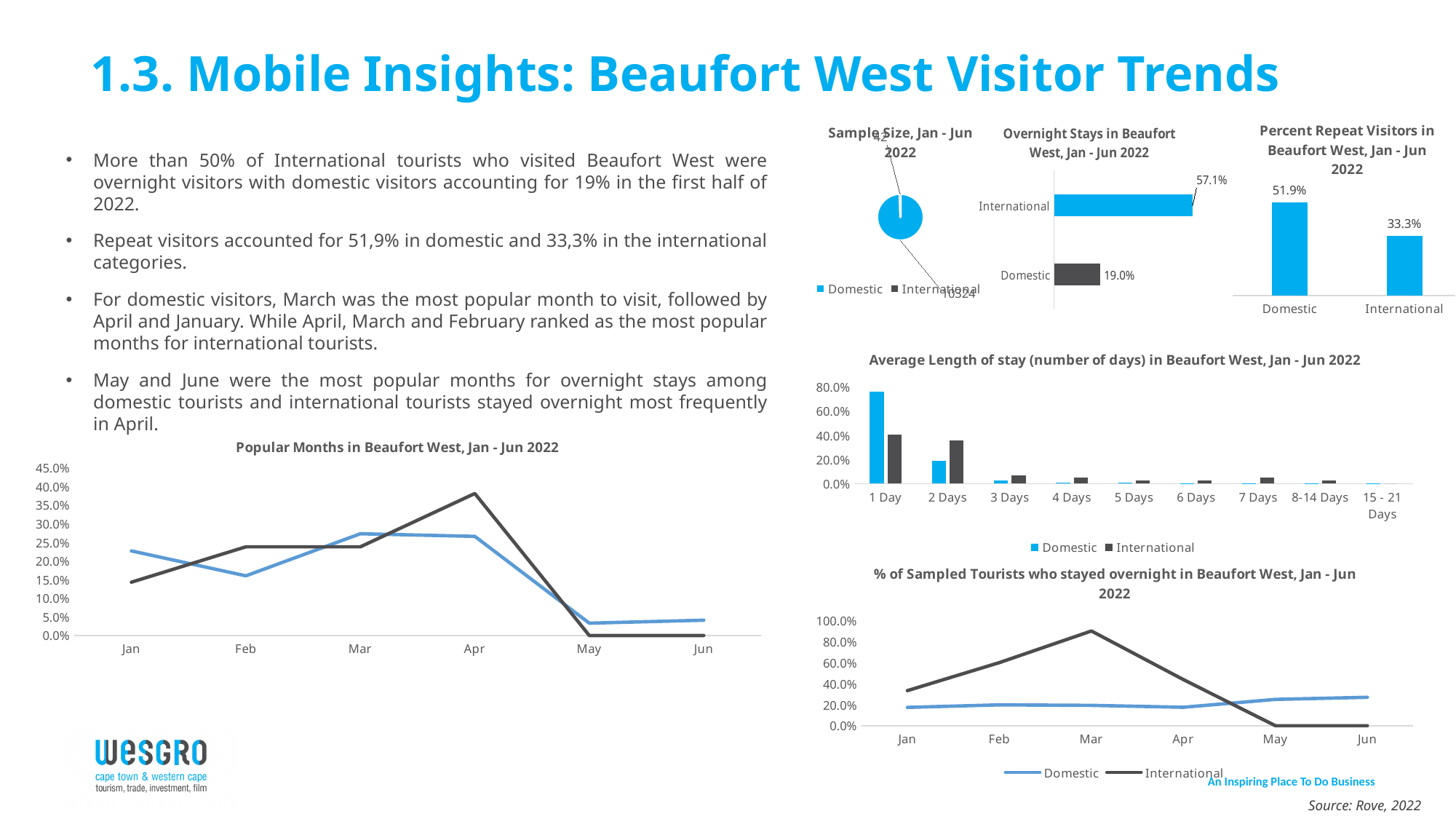
In the 'Average Length of stay (number of days) in Beaufort West, Jan - Jun 2022' chart, is the Domestic value for 1 Day greater or less than 60.0%? greater In the 'Percent Repeat Visitors in Beaufort West, Jan - Jun 2022' chart, what is the difference between the Domestic and International values? 18.6% In the '% of Sampled Tourists who stayed overnight in Beaufort West, Jan - Jun 2022' chart, how many series does the legend list? 2 What kind of chart is 'Average Length of stay (number of days) in Beaufort West, Jan - Jun 2022'? bar chart In the 'Percent Repeat Visitors in Beaufort West, Jan - Jun 2022' chart, which category has the higher value? Domestic In the 'Percent Repeat Visitors in Beaufort West, Jan - Jun 2022' chart, what is the value for Domestic? 51.9% In the 'Sample Size, Jan - Jun 2022' pie chart, which category has the larger share, Domestic or International? Domestic In the 'Overnight Stays in Beaufort West, Jan - Jun 2022' chart, what is the difference between the International and Domestic values? 38.1% In the 'Average Length of stay (number of days) in Beaufort West, Jan - Jun 2022' chart, how many length-of-stay categories are shown on the x axis? 9 In the '% of Sampled Tourists who stayed overnight in Beaufort West, Jan - Jun 2022' chart, in which month does the International line reach its highest value? Mar In the 'Overnight Stays in Beaufort West, Jan - Jun 2022' chart, what is the value for International? 57.1% In the 'Overnight Stays in Beaufort West, Jan - Jun 2022' chart, what is the value for Domestic? 19.0%